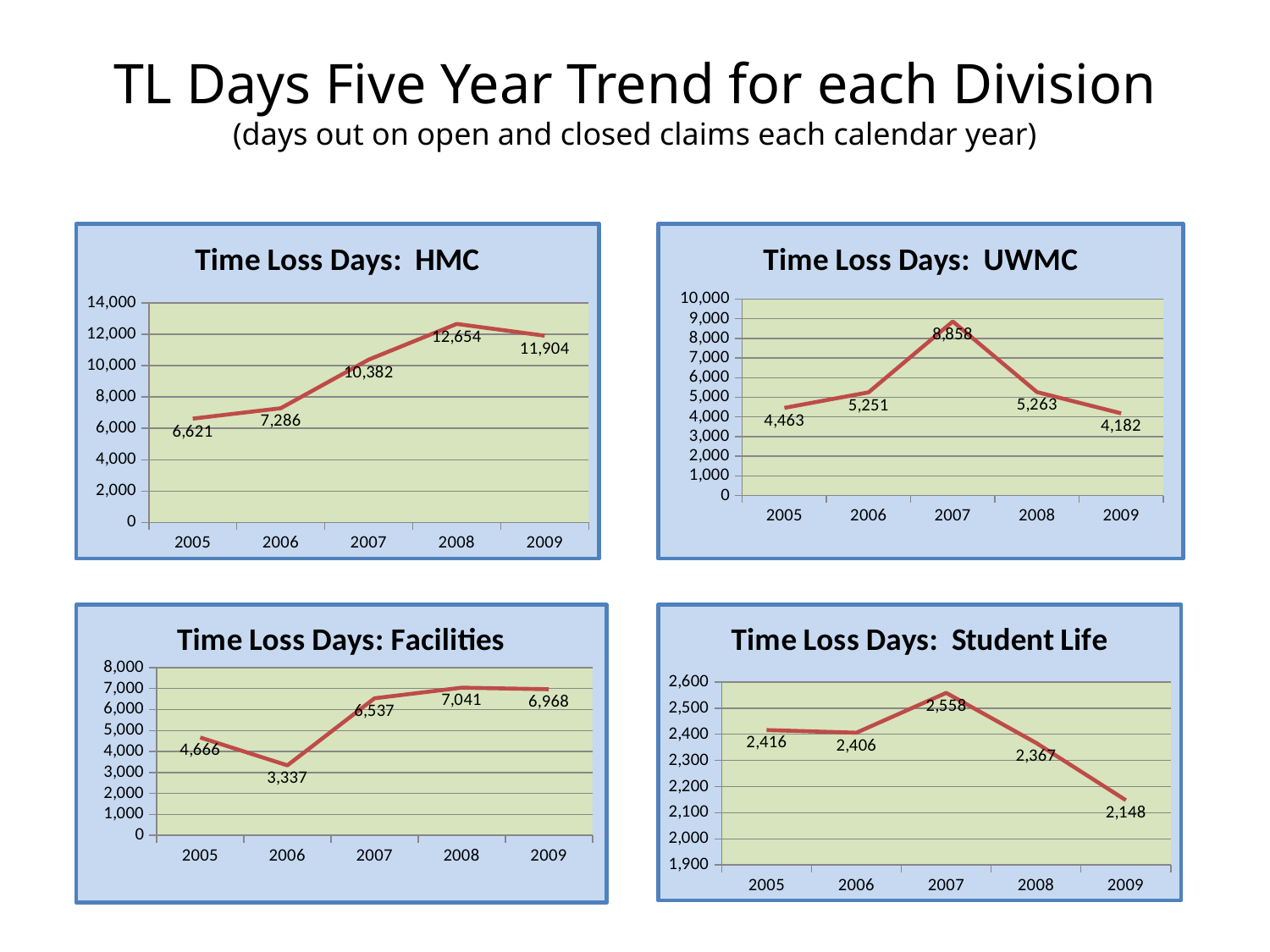
In the 'Time Loss Days: UWMC' chart, which year has the highest value? 2007 In the 'Time Loss Days: Facilities' chart, is the value for 2007 greater or less than 6,000? greater How many years are plotted in the 'Time Loss Days: Student Life' chart? 5 In the 'Time Loss Days: HMC' chart, what is the difference between the 2008 and 2009 values? 750 In the 'Time Loss Days: HMC' chart, what is the value for 2008? 12,654 In the 'Time Loss Days: UWMC' chart, which is larger, the value for 2006 or the value for 2008? 2008 How many charts are shown on the slide? 4 What kind of chart is 'Time Loss Days: HMC'? line chart In the 'Time Loss Days: Student Life' chart, what is the value for 2009? 2,148 In the 'Time Loss Days: Facilities' chart, which year has the lowest value? 2006 In the 'Time Loss Days: HMC' chart, do the values rise or fall from 2005 to 2008? rise In the 'Time Loss Days: UWMC' chart, what is the difference between the 2007 and 2009 values? 4,676